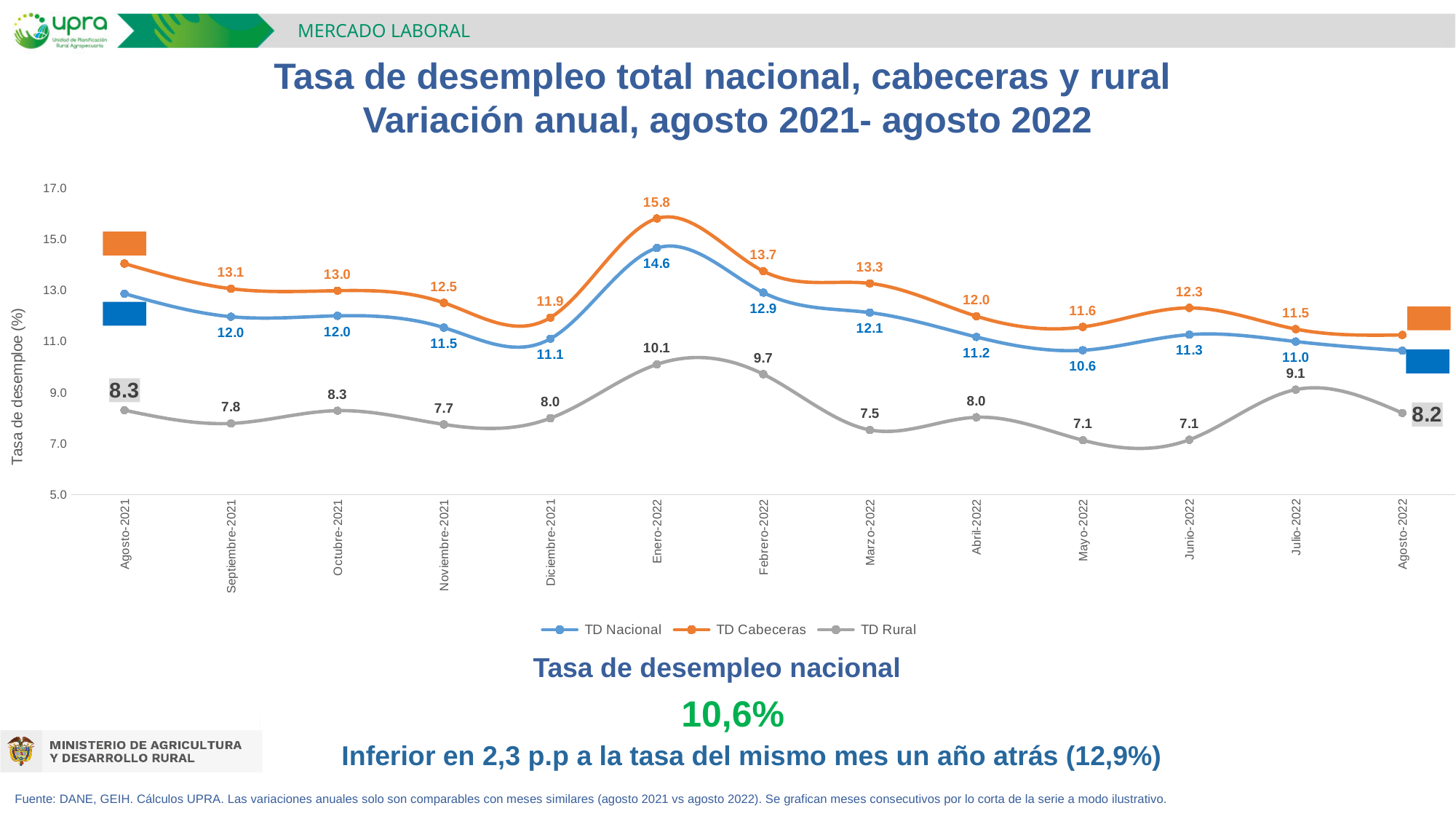
In which month does TD Nacional reach its highest value? Enero-2022 What kind of chart is shown on the slide? line chart What is the value of TD Rural in Agosto-2022? 8.2 How many months are shown on the x axis? 13 How many series does the legend list? 3 What is the difference between TD Cabeceras and TD Nacional in Enero-2022? 1.2 What is the value of TD Cabeceras in Enero-2022? 15.8 Which is larger for TD Rural: Febrero-2022 or Julio-2022? Febrero-2022 Is the value of TD Nacional in Agosto-2022 greater or less than 11.0? less Does TD Nacional rise or fall from Febrero-2022 to Mayo-2022? fall In which month does TD Rural reach its highest value? Enero-2022 What is the value of TD Nacional in Mayo-2022? 10.6